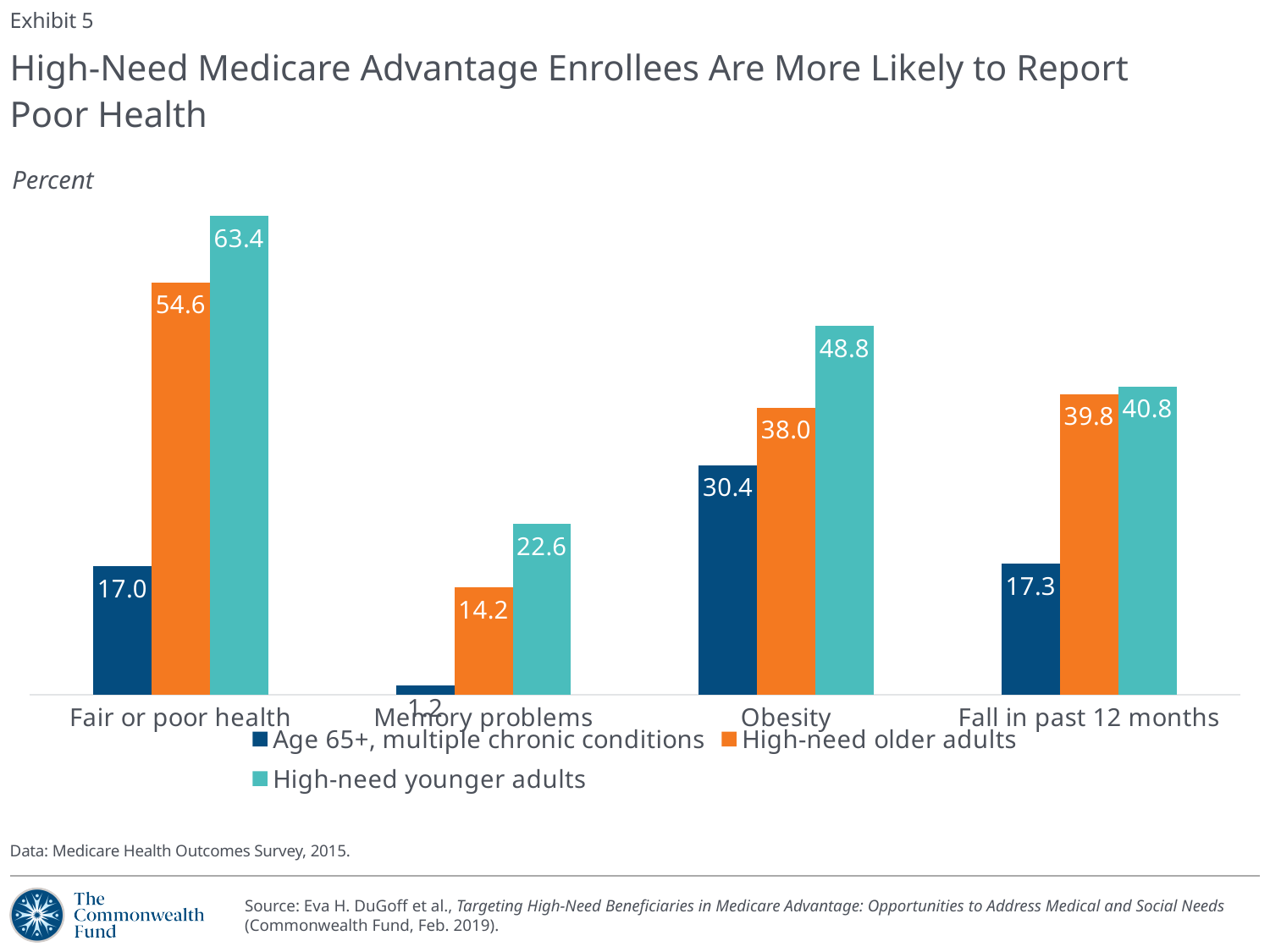
What is the difference between high-need older adults and Age 65+, multiple chronic conditions for memory problems? 13.0 What is the value for Age 65+, multiple chronic conditions for a fall in past 12 months? 17.3 What unit is indicated above the chart? Percent What kind of chart is shown on the slide? Bar chart What is the value for high-need older adults for obesity? 38.0 What percentage of high-need younger adults report fair or poor health? 63.4 What is the difference between high-need younger adults and high-need older adults for fair or poor health? 8.8 How many categories are shown on the x axis? 4 How many series does the legend list? 3 Which category has the lowest value for Age 65+, multiple chronic conditions? Memory problems For obesity, which is larger: the value for high-need younger adults or for Age 65+, multiple chronic conditions? High-need younger adults Which category has the highest value for high-need younger adults? Fair or poor health